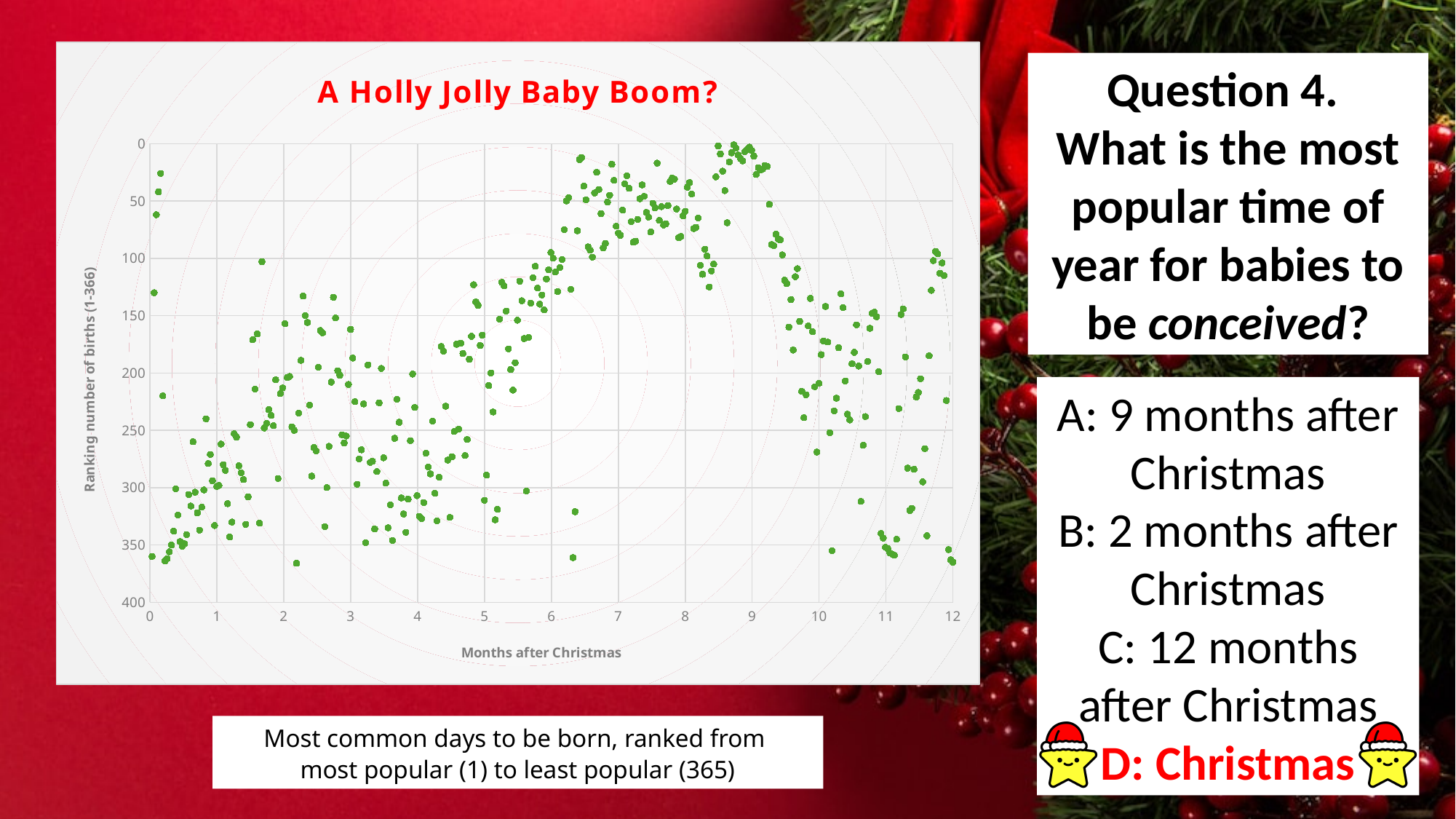
Around which month after Christmas do the points reach the best ranking (closest to 0)? 9 Which has the better (lower) ranking numbers: the points around month 9 or the points around month 2? Month 9 What is the title of the chart? A Holly Jolly Baby Boom? What kind of chart is shown on the slide? Scatter plot What is the highest value shown on the y axis of the chart? 400 Do the ranking numbers generally decrease or increase as the months go from 4 to 9? Decrease Are the ranking numbers for the points at month 9 mostly greater or less than 50? Less Are the ranking numbers for the points at month 7 mostly greater or less than 150? Less What is the label of the x axis of the chart? Months after Christmas What is the highest value shown on the x axis of the chart? 12